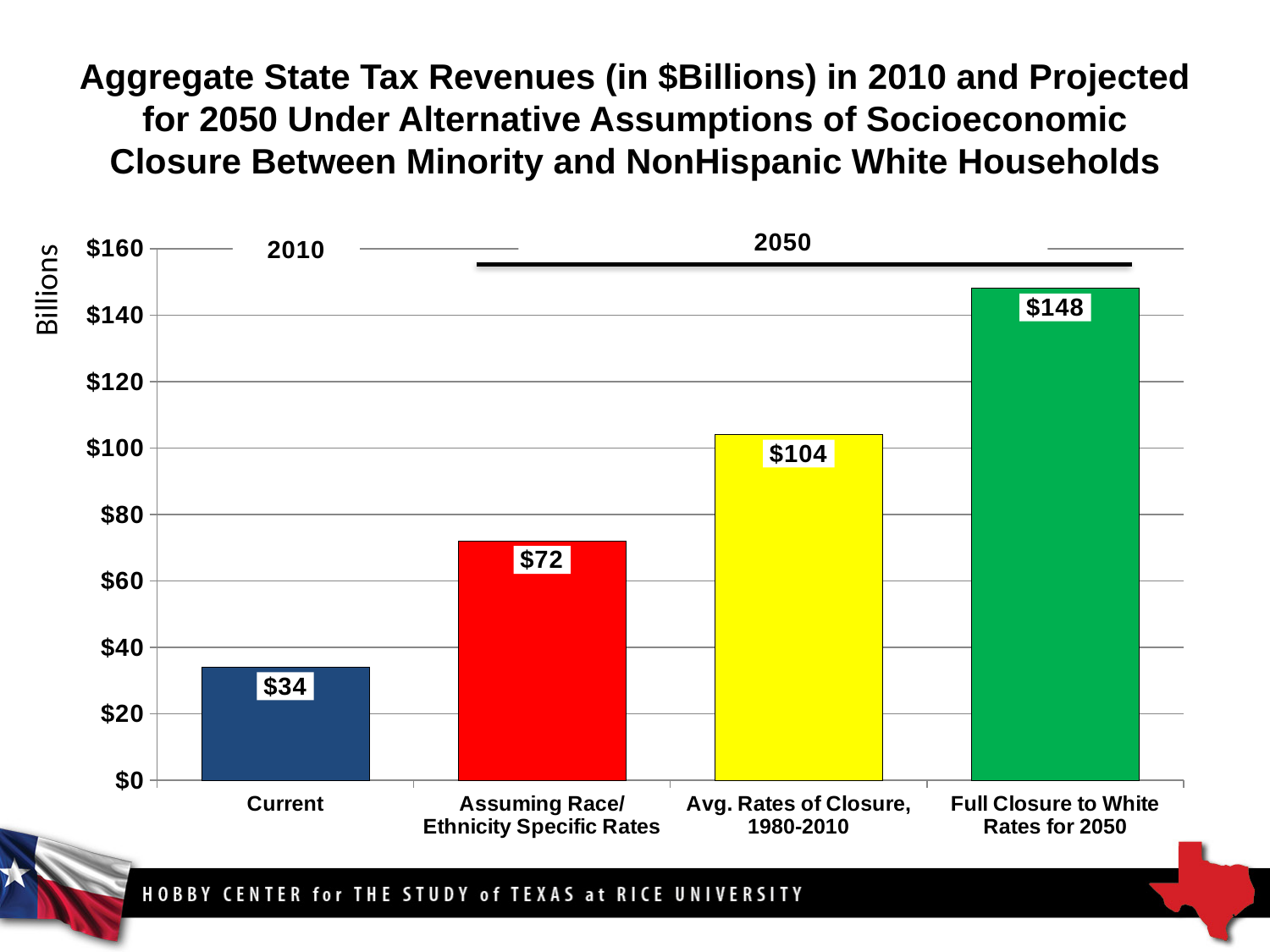
Which category has the highest value? Full Closure to White Rates for 2050 What is the value for Full Closure to White Rates for 2050? $148 How many categories are shown on the chart? 4 What kind of chart is this? Bar chart What is the label on the vertical axis? Billions What is the value for Avg. Rates of Closure, 1980-2010? $104 What is the value for the Current category? $34 Which is larger, Assuming Race/Ethnicity Specific Rates or Avg. Rates of Closure, 1980-2010? Avg. Rates of Closure, 1980-2010 What is the difference between Full Closure to White Rates for 2050 and Current? $114 What is the value for Assuming Race/Ethnicity Specific Rates? $72 What is the difference between Avg. Rates of Closure, 1980-2010 and Assuming Race/Ethnicity Specific Rates? $32 Which category has the lowest value? Current